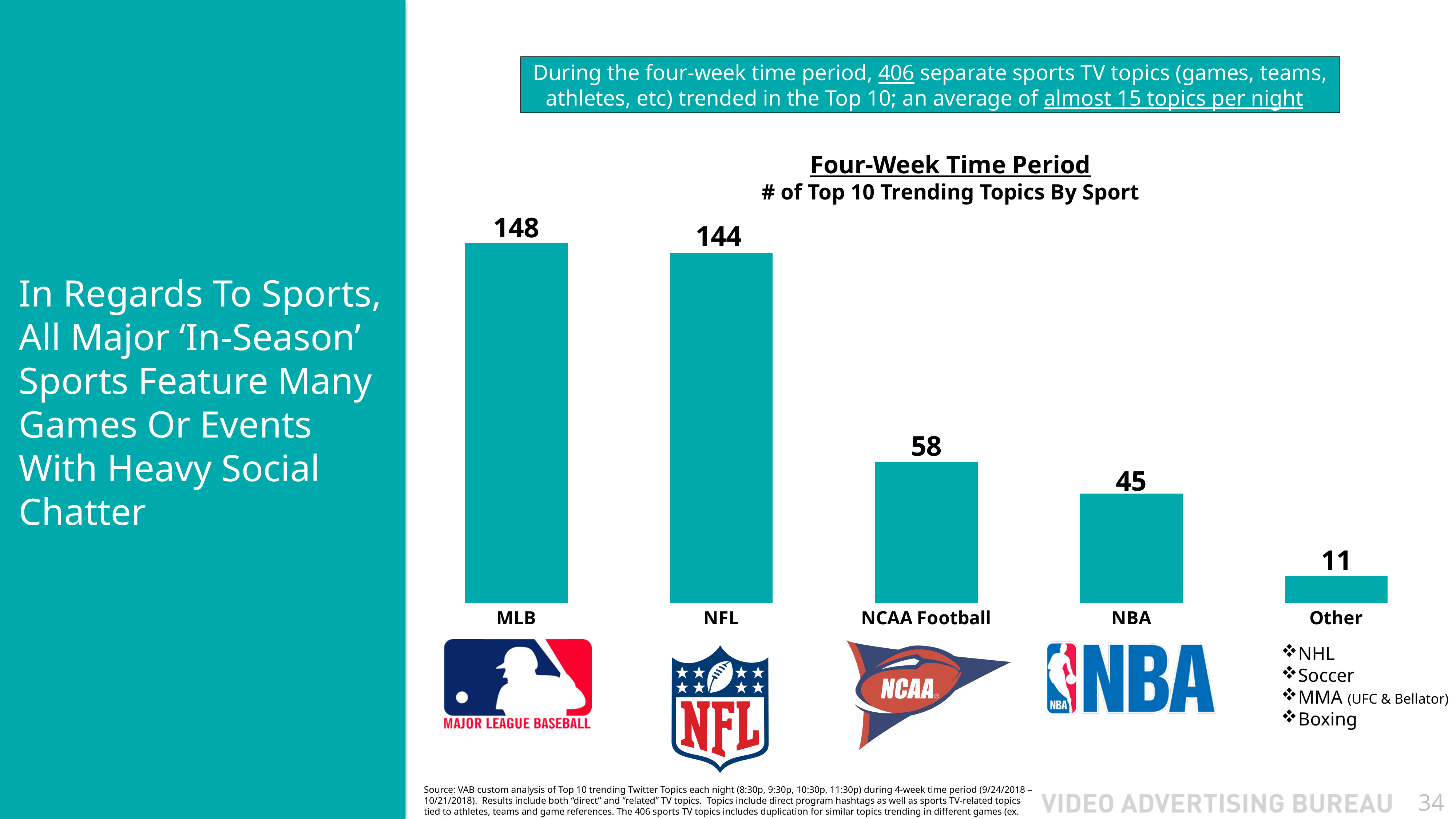
What is the number of Top 10 trending topics for NCAA Football? 58 Which sport has the highest number of Top 10 trending topics? MLB What is the difference between the NCAA Football and NBA values? 13 What is the title of the chart? Four-Week Time Period # of Top 10 Trending Topics By Sport What is the number of Top 10 trending topics for MLB? 148 Which has more Top 10 trending topics, NFL or NCAA Football? NFL Which category has the lowest number of Top 10 trending topics? Other What is the difference between the MLB and NFL values? 4 How many sport categories are shown in the chart? 5 What type of chart is shown on the slide? Bar chart What is the number of Top 10 trending topics for NBA? 45 What is the number of Top 10 trending topics for Other? 11